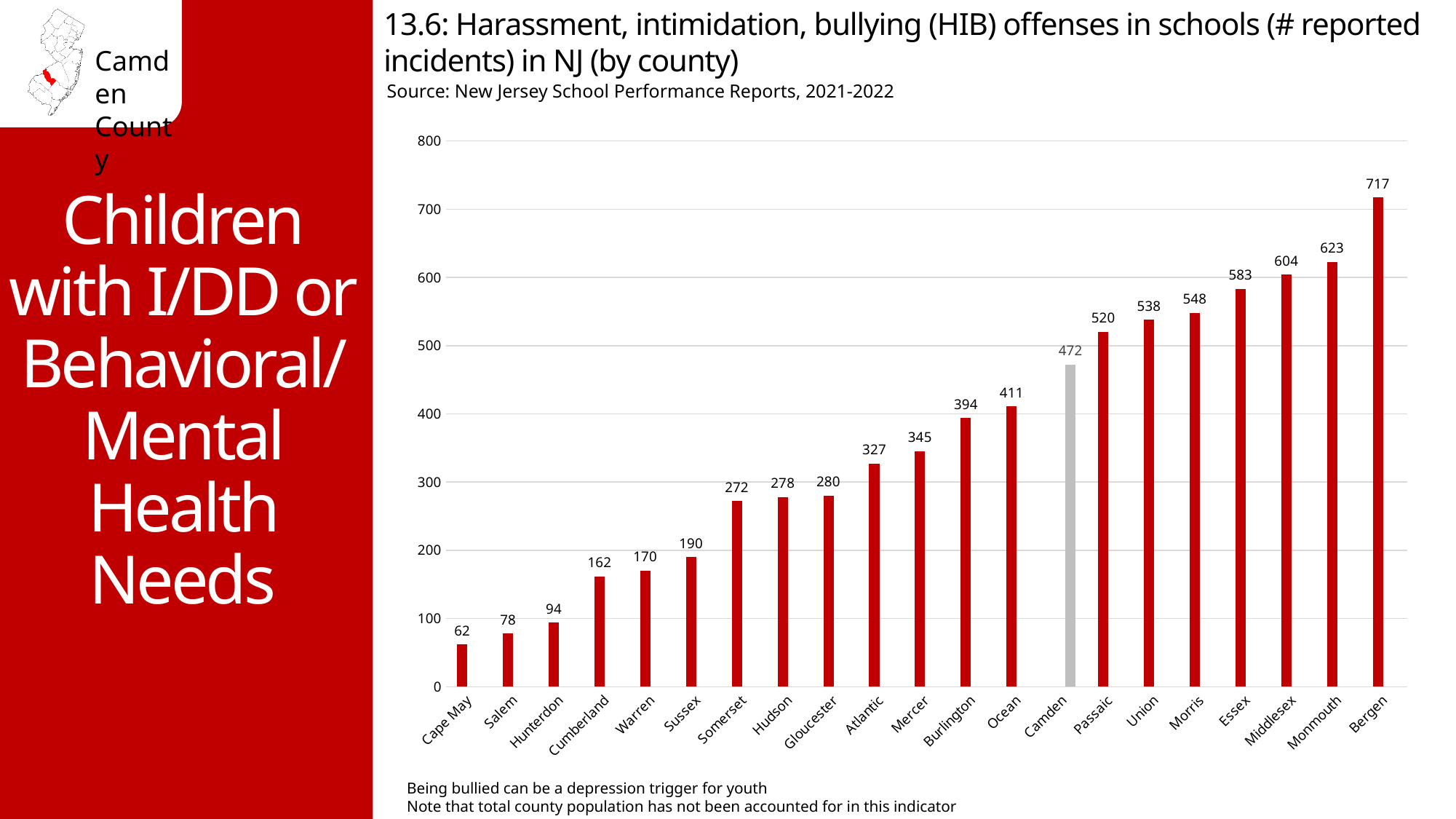
Which county's bar is coloured grey instead of red? Camden Is the value for Monmouth greater or less than 600? greater Which has a higher value, Passaic or Ocean? Passaic How many reported HIB incidents does the chart show for Camden? 472 What is the value shown for Bergen? 717 Which county has the highest number of reported HIB incidents? Bergen What kind of chart is this? Bar chart How many counties are shown on the x axis? 21 Do the values rise or fall moving from left to right along the x axis? Rise Which county has the lowest number of reported HIB incidents? Cape May What is the difference between the values for Bergen and Camden? 245 What is the value shown for Cape May? 62